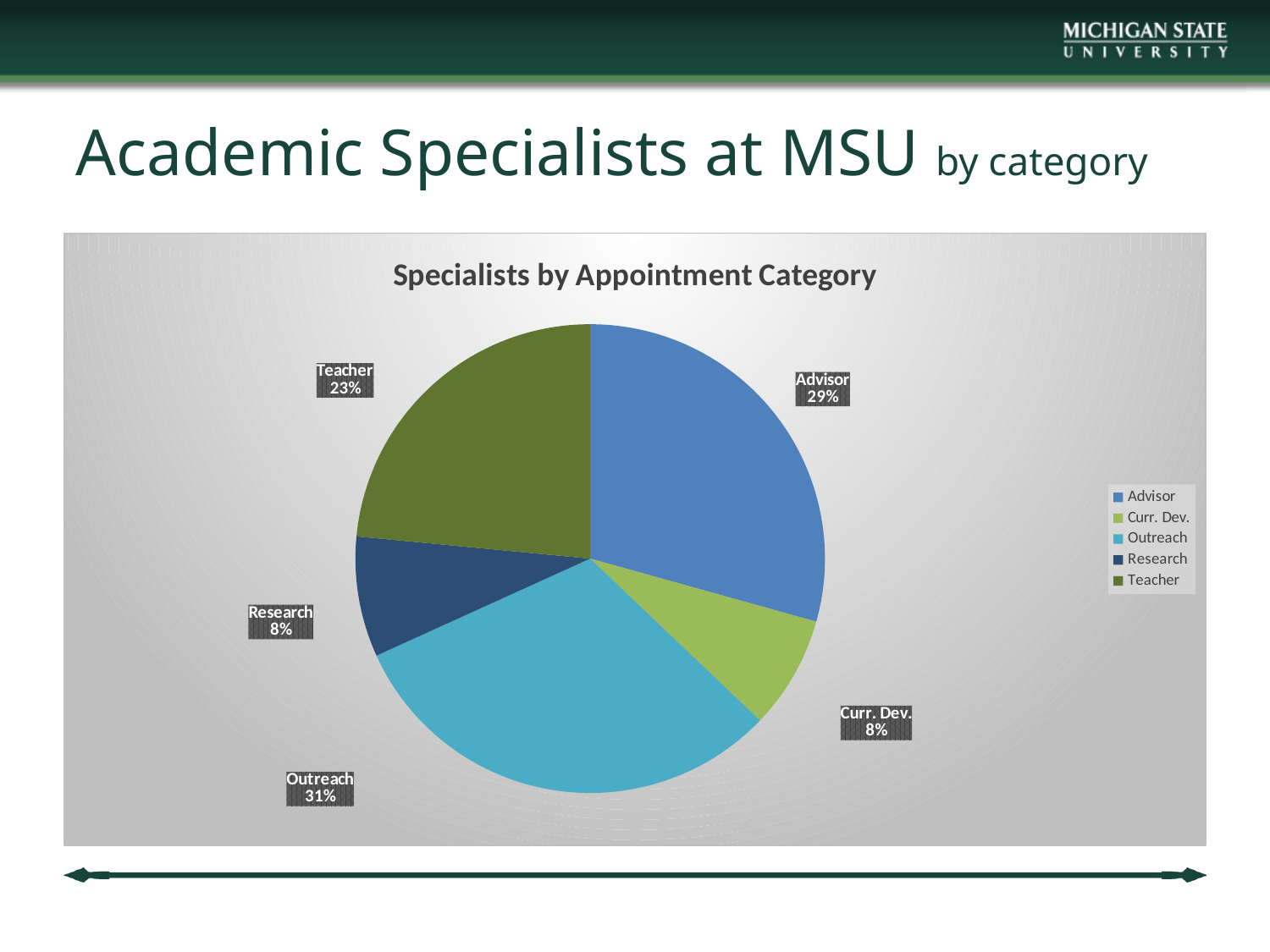
What is the difference in percentage points between Outreach and Advisor? 2 What kind of chart is shown on the slide? Pie chart What is the difference in percentage points between Advisor and Teacher? 6 What is the value shown for Teacher? 23% Which category has the largest slice of the pie? Outreach What is the title of the chart? Specialists by Appointment Category What is the value shown for Advisor? 29% What share of the pie does Outreach represent? 31% Which is larger, the Teacher slice or the Curr. Dev. slice? Teacher How many categories are shown in the pie chart? 5 What is the value shown for Research? 8% How many entries does the legend list? 5